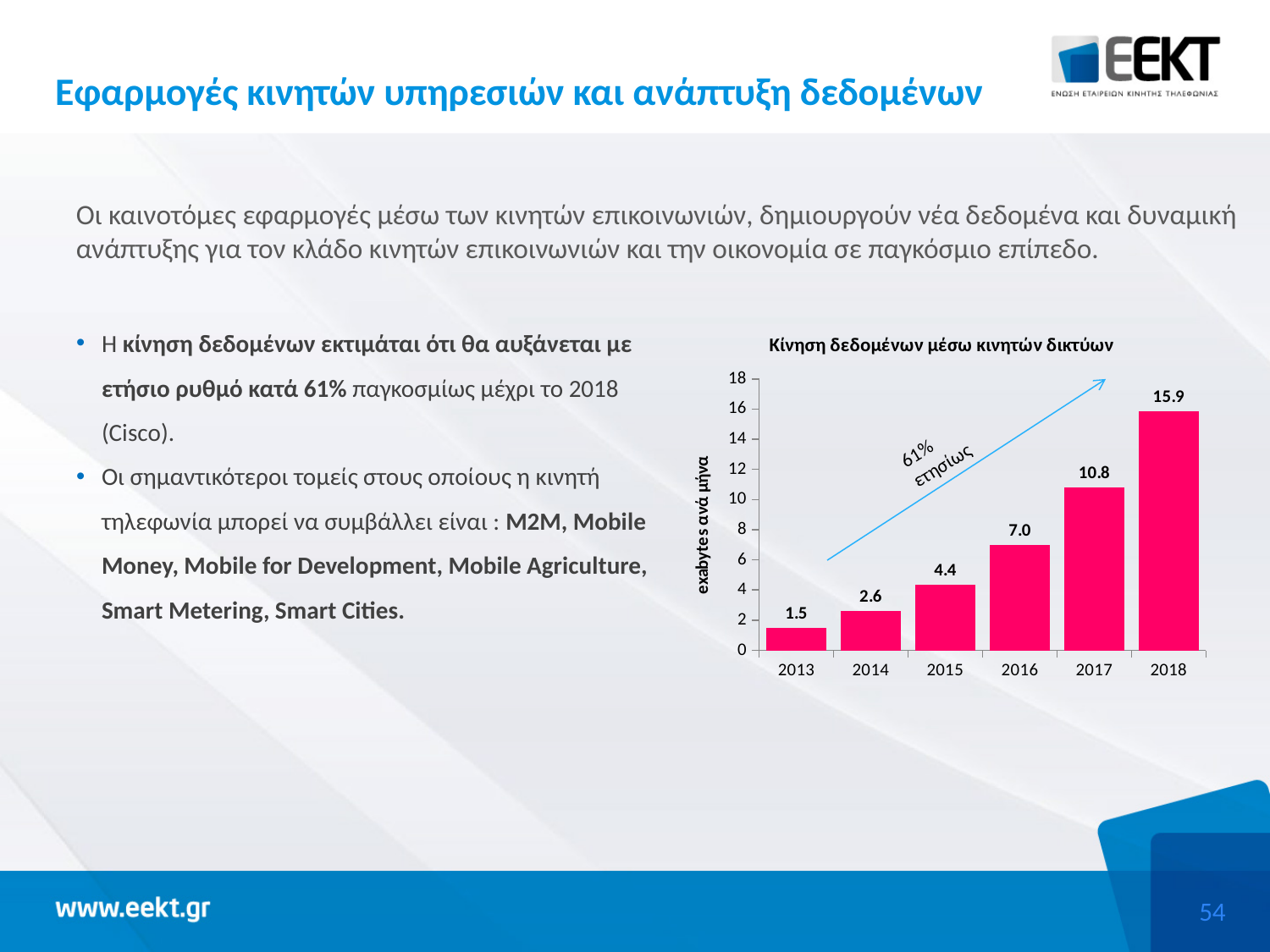
What is the value for 2018? 15.9 Is the value for 2017 greater or less than 10? greater What is the difference between the values for 2015 and 2014? 1.8 What is the value for 2016? 7.0 What kind of chart is shown? bar chart What is the value for 2013? 1.5 Do the values rise or fall from 2013 to 2018? rise Which year has the highest value? 2018 Which year has the lowest value? 2013 Which is larger, the value for 2016 or the value for 2015? 2016 How many years are shown on the x axis? 6 What is the difference between the values for 2018 and 2017? 5.1